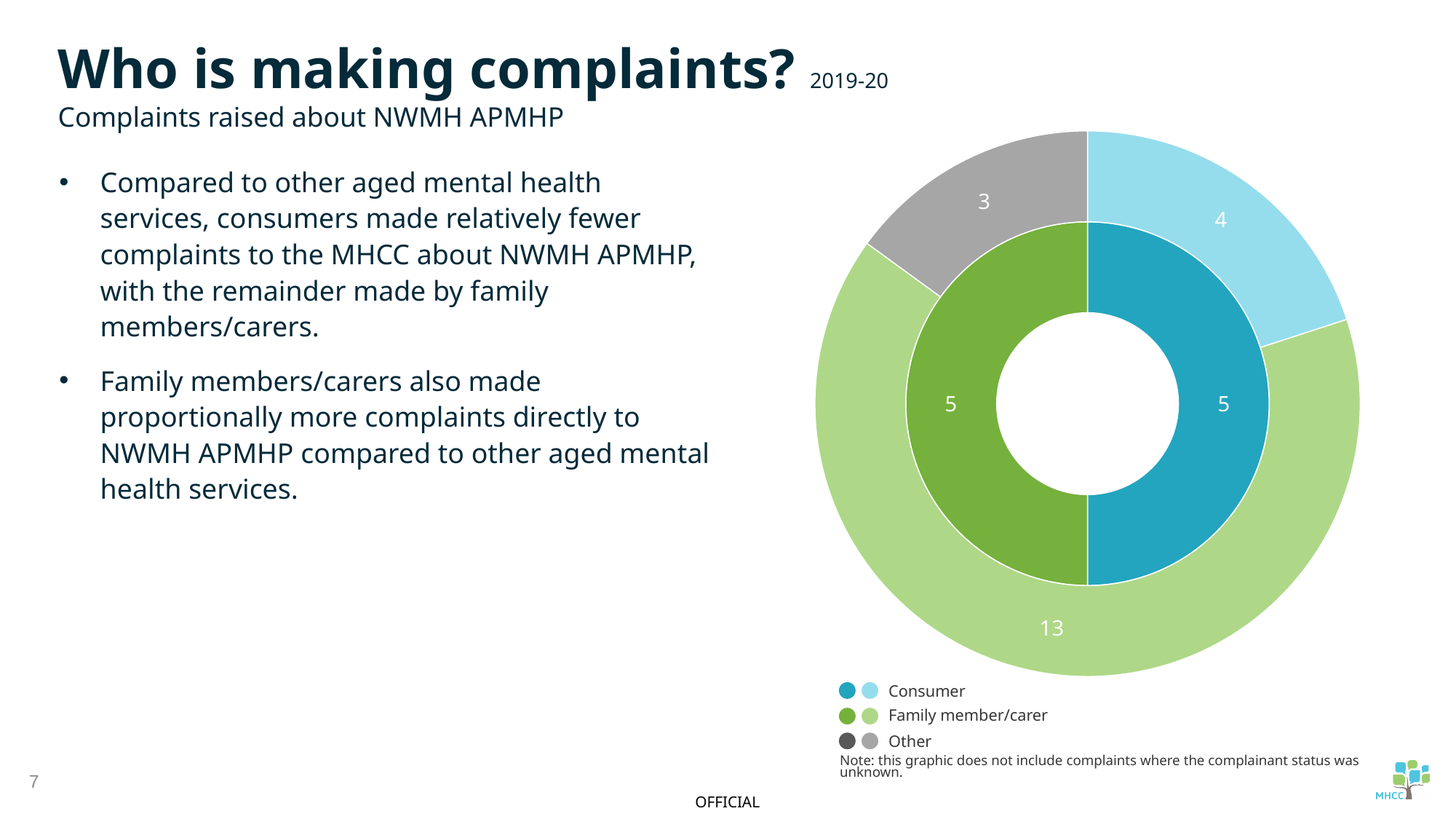
How many categories does the chart's legend list? 3 What kind of chart is shown on the slide? Doughnut chart In the outer ring of the chart, what is the value for Family member/carer? 13 In the inner ring of the chart, what is the value for Family member/carer? 5 In the inner ring of the chart, what is the value for Consumer? 5 What is the total of the values shown in the outer ring of the chart? 20 In the outer ring of the chart, what is the value for Other? 3 In the outer ring of the chart, what is the value for Consumer? 4 Which category has the largest value in the outer ring of the chart? Family member/carer Which category has the smallest value in the outer ring of the chart? Other In the outer ring, how much larger is the Family member/carer value than the Consumer value? 9 In the outer ring, which is larger: the value for Consumer or the value for Other? Consumer